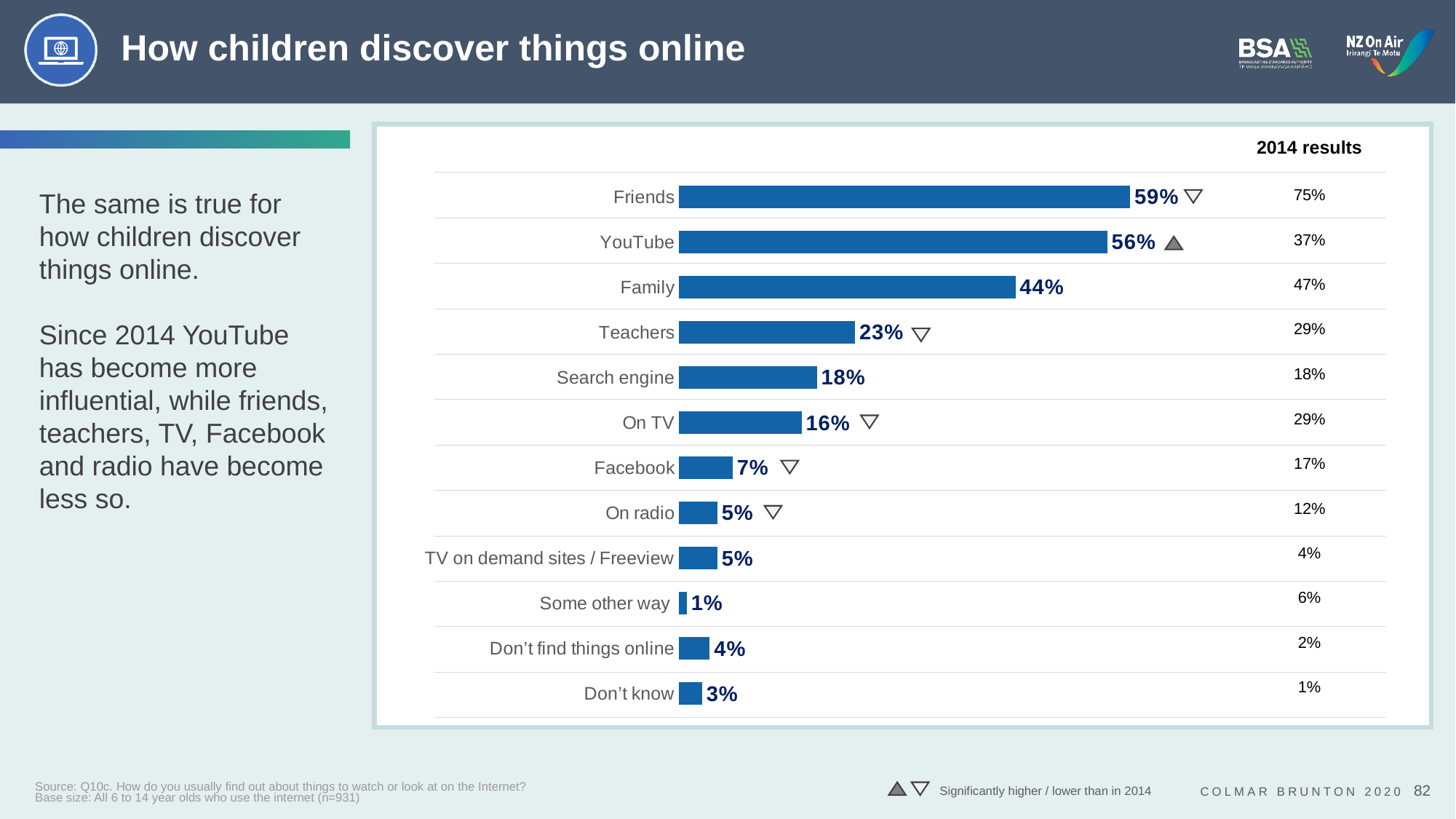
What is the value shown for YouTube? 56% How many categories are shown in the chart? 12 What percentage of children discover things online through Friends? 59% What is the heading of the column of values on the right side of the chart? 2014 results What was the 2014 result for YouTube shown in the right-hand column? 37% Which is larger, the value for On TV or the value for Facebook? On TV Which category has the highest value in the chart? Friends What is the value shown for Search engine? 18% What is the difference between the values for Family and Teachers? 21% Which category has the lowest value in the chart? Some other way What kind of chart is shown on the slide? Bar chart What is the difference between the values for Friends and YouTube? 3%